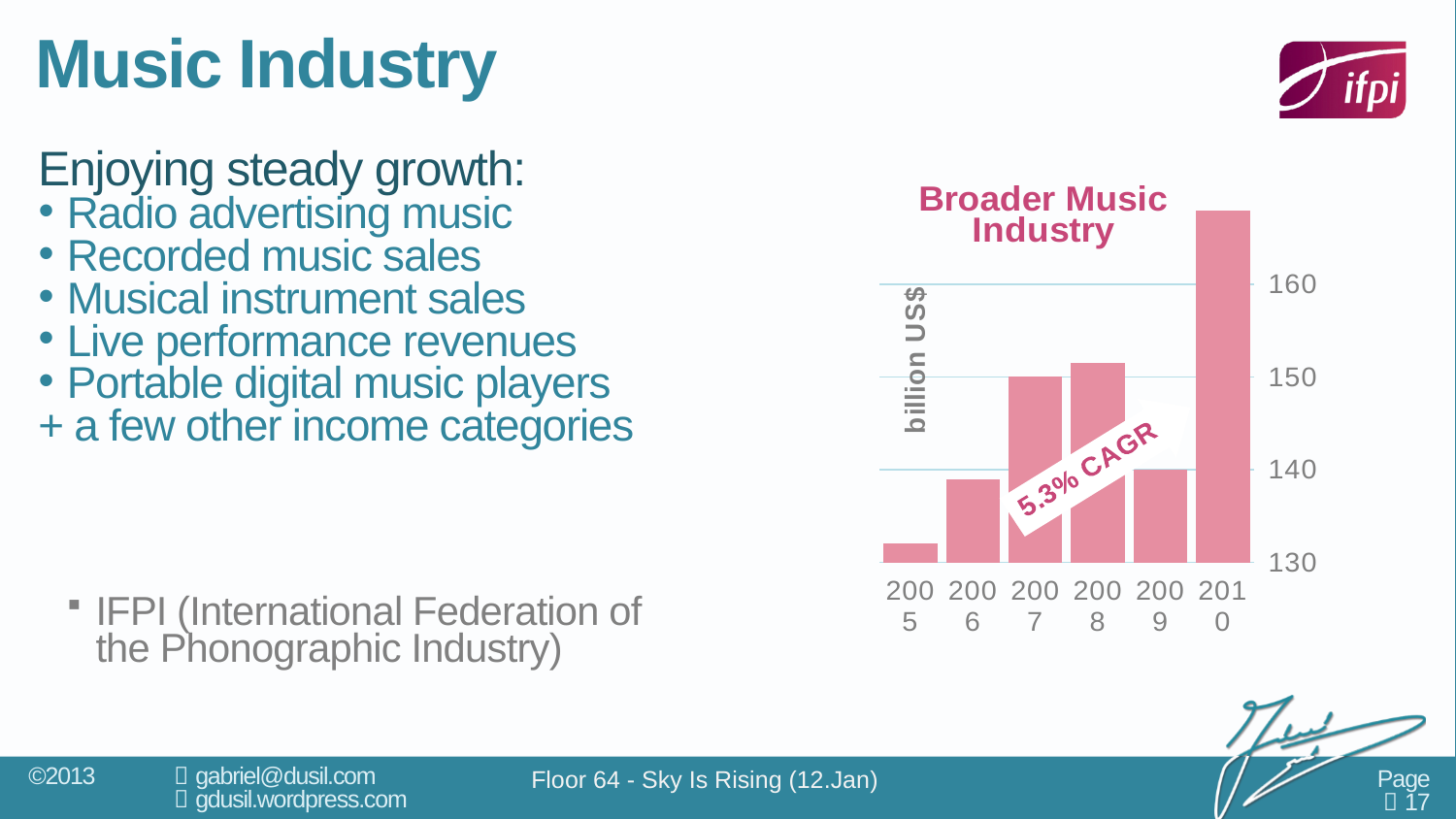
What is the title of the chart? Broader Music Industry Which year has the larger value, 2007 or 2006? 2007 Which year has the lowest value in the chart? 2005 Is the value for 2009 greater or less than 150? less Is the value for 2005 greater or less than 140? less How many years (bars) are plotted in the chart? 6 Which year has the larger value, 2008 or 2009? 2008 Which year has the highest value in the chart? 2010 What unit is shown on the chart's vertical axis label? billion US$ What kind of chart is shown on the slide? bar chart Is the value for 2007 greater or less than 140? greater